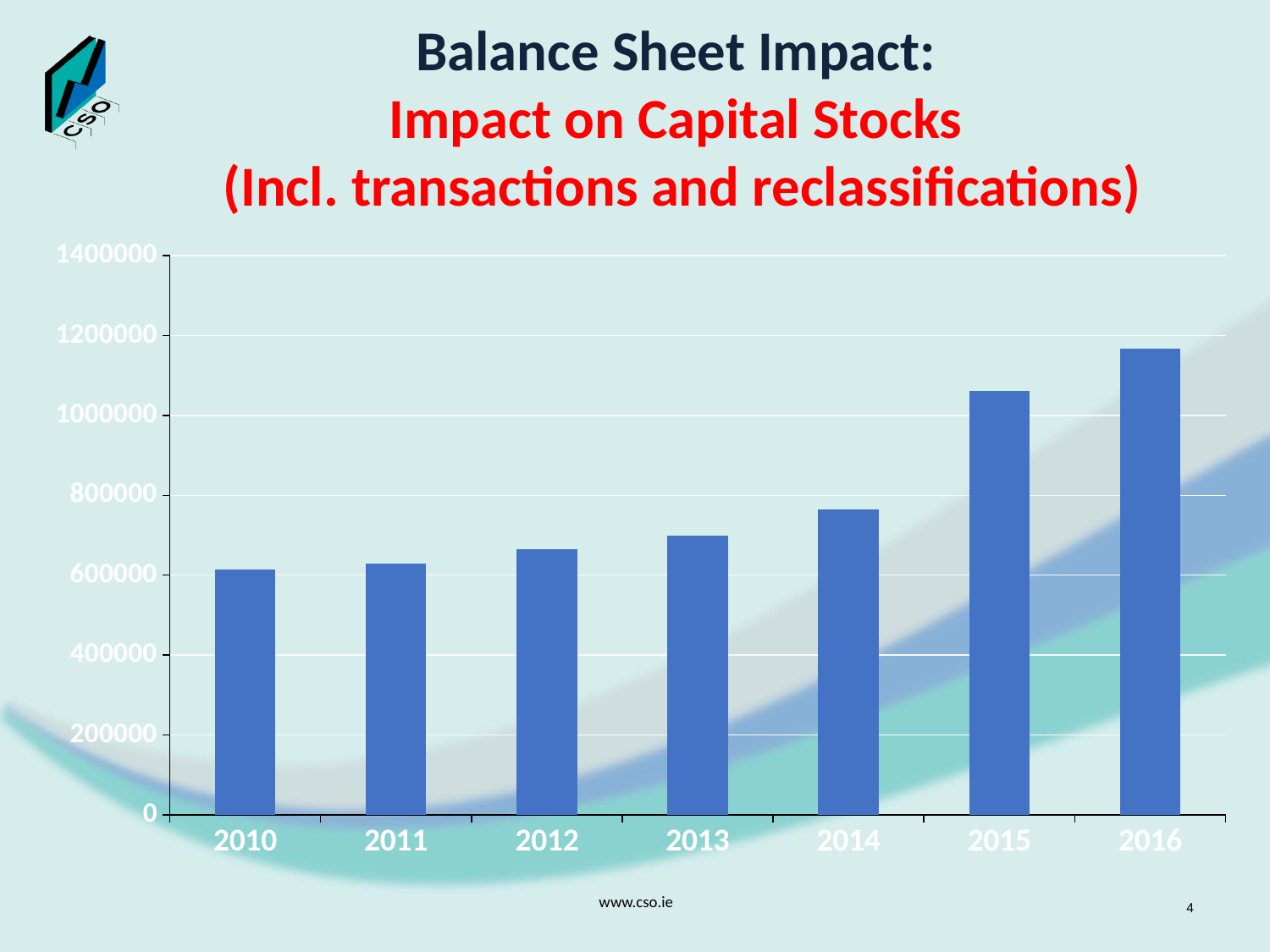
What is the first line of the slide title above the chart? Balance Sheet Impact: Is the value for 2016 greater or less than 1000000? greater Do the values rise or fall from 2010 to 2016? rise Is the value for 2015 greater or less than 1200000? less What kind of chart is shown on the slide? bar chart Which year has the highest value in the chart? 2016 How many years are shown on the x axis of the chart? 7 Which is larger, the value for 2015 or the value for 2014? 2015 Which year has the lowest value in the chart? 2010 Is the value for 2010 greater or less than 400000? greater Which is larger, the value for 2012 or the value for 2016? 2016